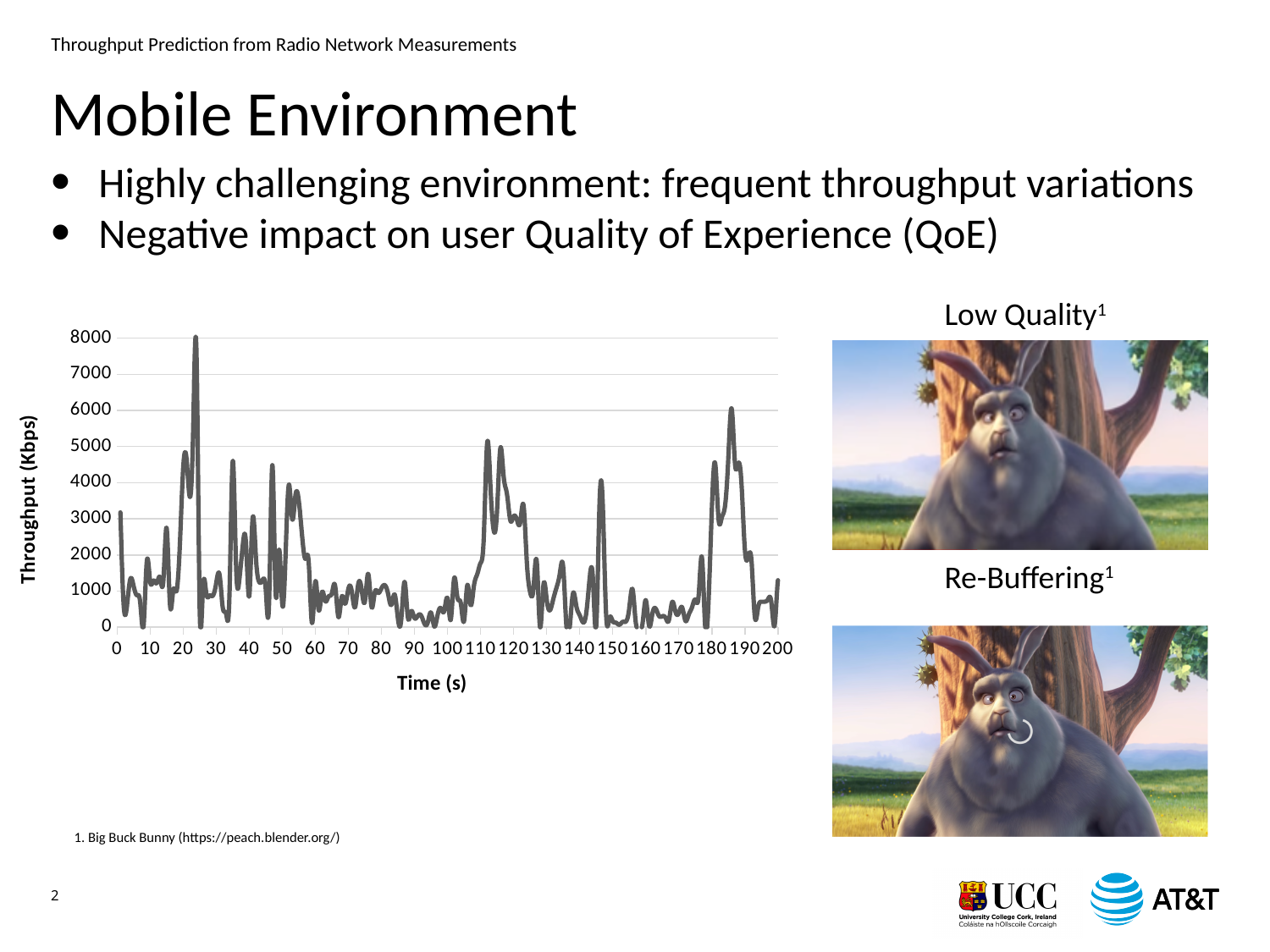
How many tick labels are shown on the x axis of the chart? 21 What is the highest value shown on the y axis of the chart? 8000 What is the largest time value shown on the x axis of the chart? 200 What is the label of the y axis of the chart? Throughput (Kbps) Is the throughput at 0 s greater or less than 2000 Kbps? greater What is the label of the x axis of the chart? Time (s) What kind of chart is shown on the slide? line chart Is the throughput at 150 s greater or less than 1000 Kbps? less Is the highest throughput peak in the chart greater or less than 7000 Kbps? greater Does the throughput stay roughly constant or fluctuate strongly over time in the chart? fluctuates strongly